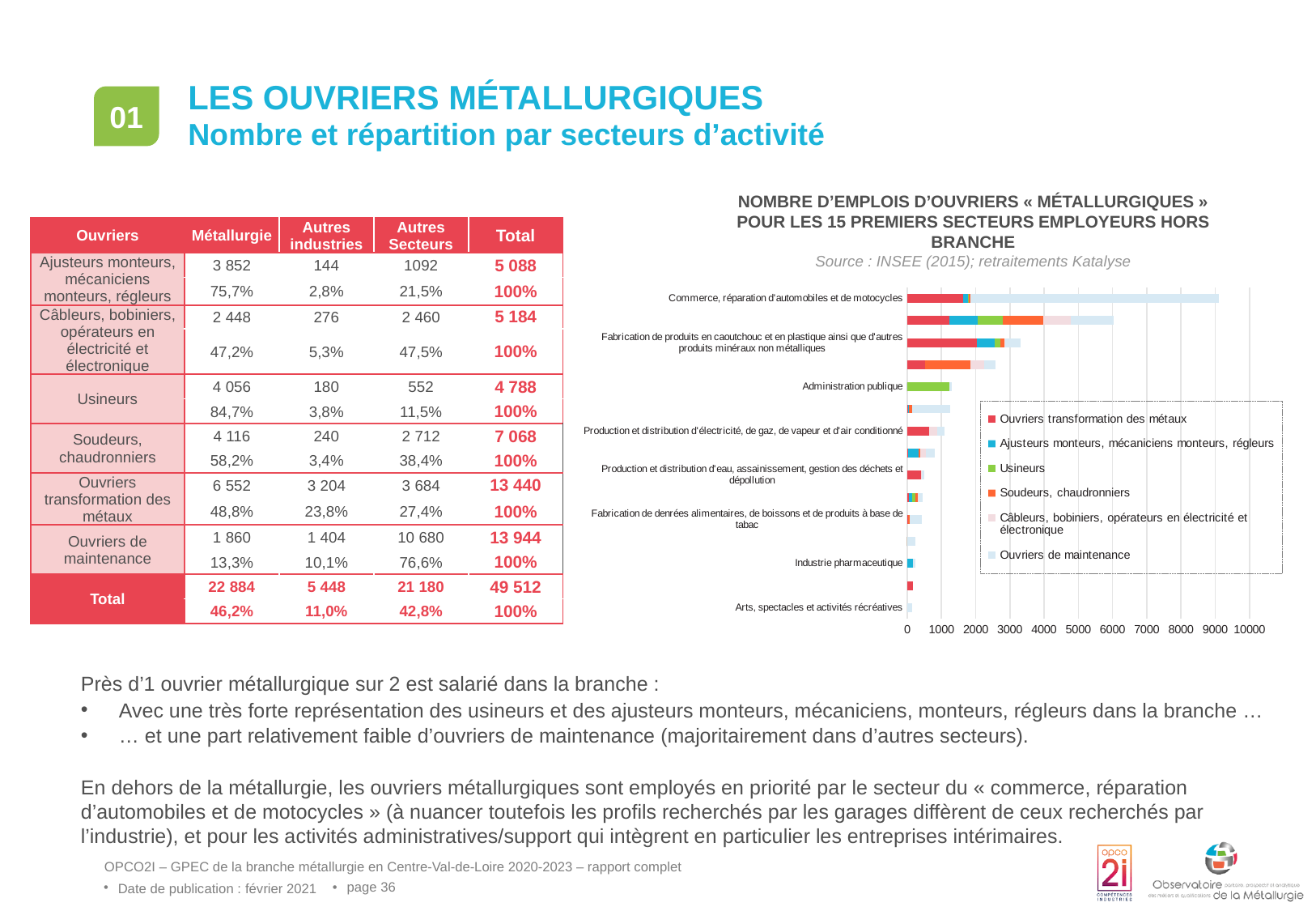
Do the bars get longer or shorter going from the top of the chart to the bottom? shorter Is the total bar length for Industrie pharmaceutique greater or less than 1000? less Which labelled sector has the shortest bar in the chart? Arts, spectacles et activités récréatives How many series does the legend of the bar chart list? 6 Is the total bar length for Administration publique greater or less than 2000? less What kind of chart is shown on the right of the slide? bar chart Which bar is longer: Commerce, réparation d'automobiles et de motocycles or Administration publique? Commerce, réparation d'automobiles et de motocycles Is the total bar length for Commerce, réparation d'automobiles et de motocycles greater or less than 8000? greater Which sector has the longest bar in the chart? Commerce, réparation d'automobiles et de motocycles Which series in the legend is shown in green? Usineurs How many sectors (bars) are plotted in the bar chart? 15 What is the source cited under the chart title? INSEE (2015); retraitements Katalyse